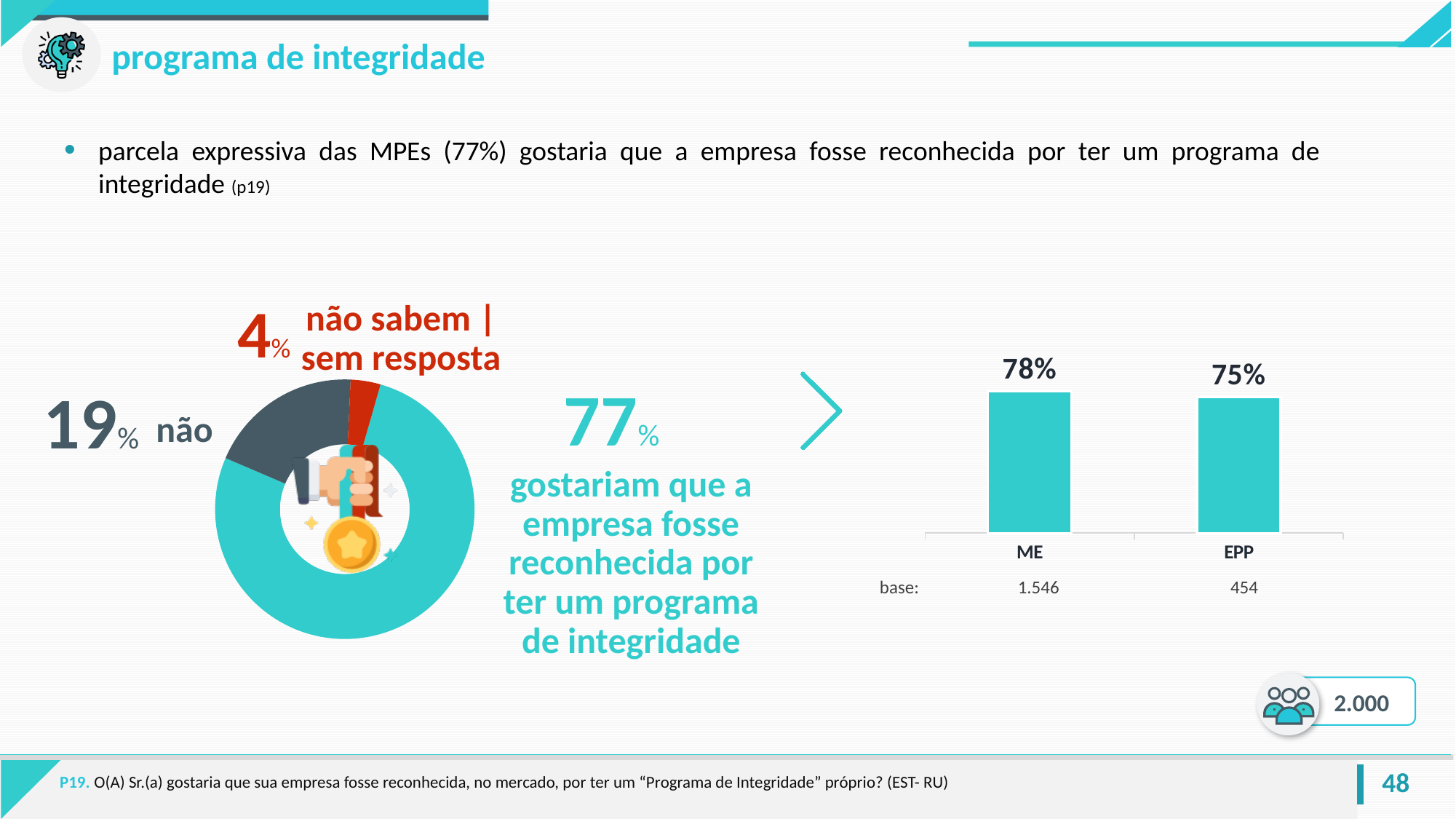
In the donut chart on the left, what share of respondents answered 'não'? 19% In the bar chart on the right, which category has the higher value, ME or EPP? ME In the donut chart on the left, what share of respondents is 'não sabem | sem resposta'? 4% In the bar chart on the right, what is the difference between the values for ME and EPP? 3 percentage points In the bar chart on the right, what is the value for EPP? 75% In the bar chart on the right, how many categories are shown? 2 In the bar chart on the right, what is the base (number of respondents) for EPP? 454 What kind of chart is shown on the left side of the slide? Donut (pie) chart What kind of chart is shown on the right side of the slide? Bar chart In the bar chart on the right, what is the base (number of respondents) for ME? 1.546 In the bar chart on the right, what is the value for ME? 78% In the donut chart on the left, what share of respondents would like the company to be recognized for having an integrity program? 77%